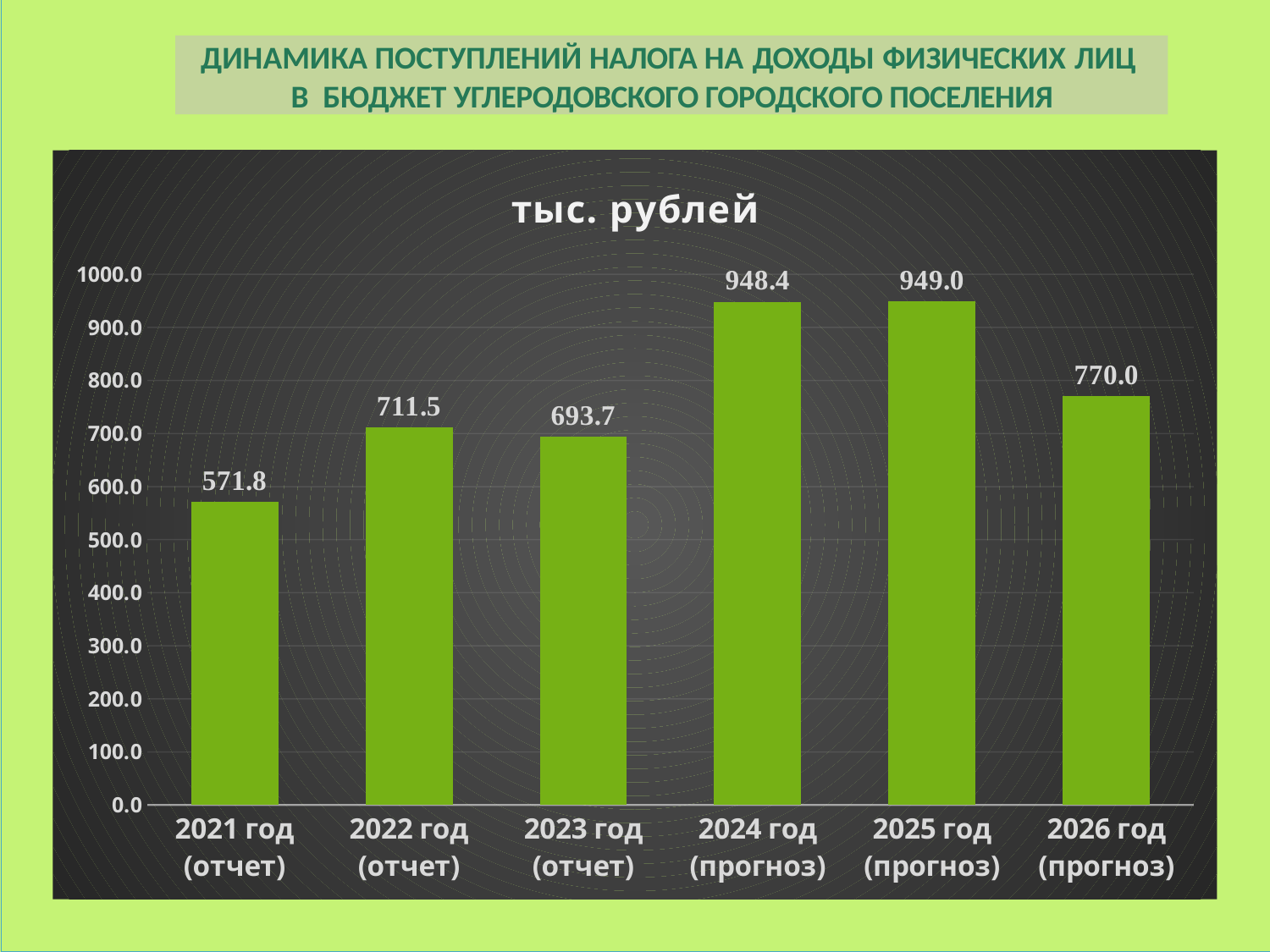
How many years are shown on the x axis? 6 Which is larger, the value for 2022 год (отчет) or 2023 год (отчет)? 2022 год (отчет) What is the title shown above the chart's plot area? тыс. рублей What is the value for 2026 год (прогноз)? 770.0 What is the value for 2021 год (отчет)? 571.8 Which year has the highest value? 2025 год (прогноз) What is the difference between the values for 2022 год (отчет) and 2021 год (отчет)? 139.7 What kind of chart is shown on the slide? bar chart What is the value for 2024 год (прогноз)? 948.4 Is the value for 2023 год (отчет) greater or less than 700.0? less Which year has the lowest value? 2021 год (отчет) What is the difference between the values for 2025 год (прогноз) and 2026 год (прогноз)? 179.0